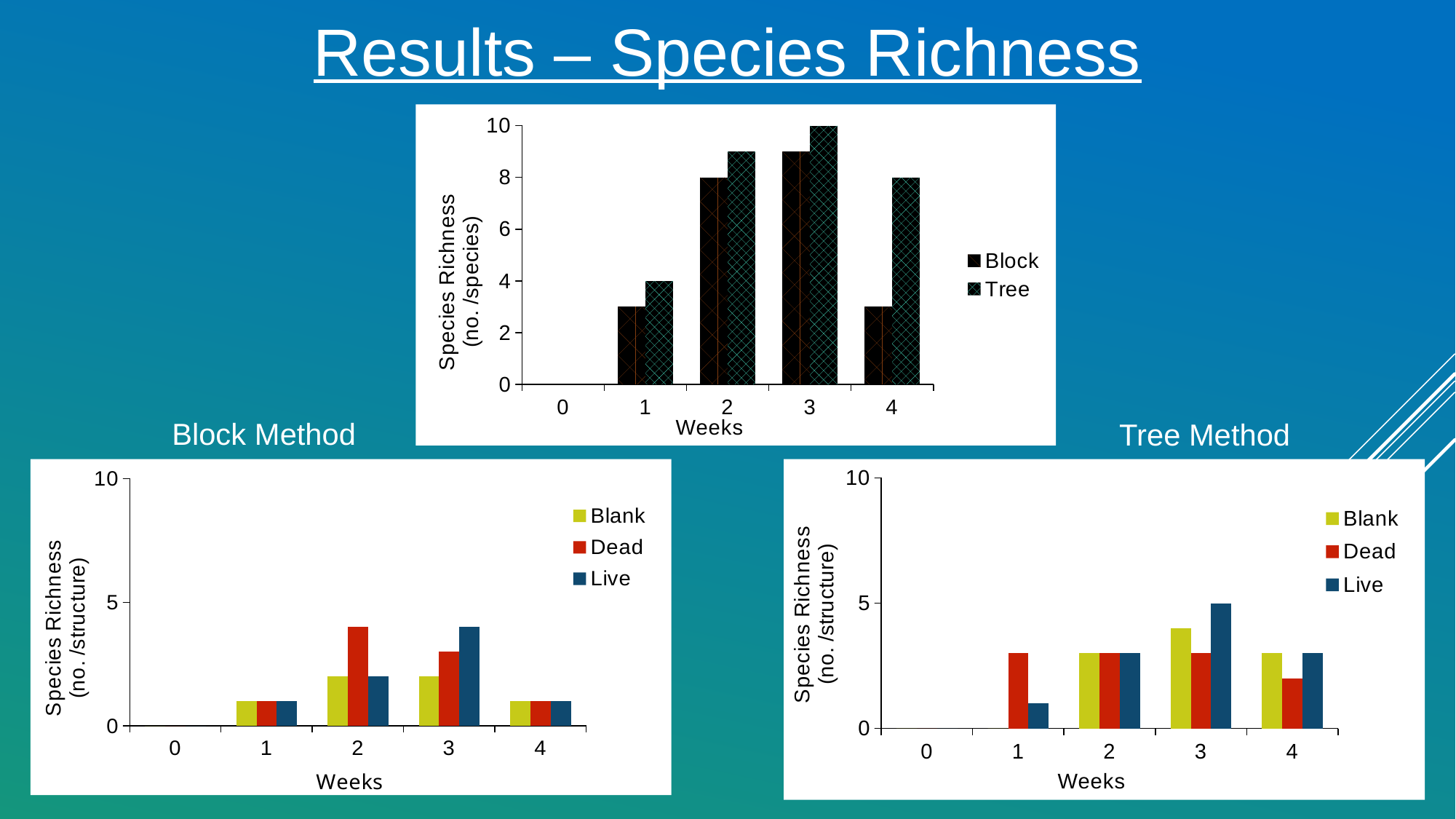
In the top chart, at which week is the Tree value highest? 3 In the Block Method chart, how many series does the legend list? 3 In the Tree Method chart, which series has the highest value at week 3? Live In the Block Method chart, which series has the highest value at week 2? Dead In the top chart, what is the Block value at week 2? 8 In the top chart, at week 4, which series has the larger value, Block or Tree? Tree In the Tree Method chart, what is the Live value at week 3? 5 In the top chart, is the Block value at week 1 greater or less than 4? less In the top chart, what is the Tree value at week 4? 8 In the top chart, what kind of chart is shown? bar chart In the top chart, how many series does the legend list? 2